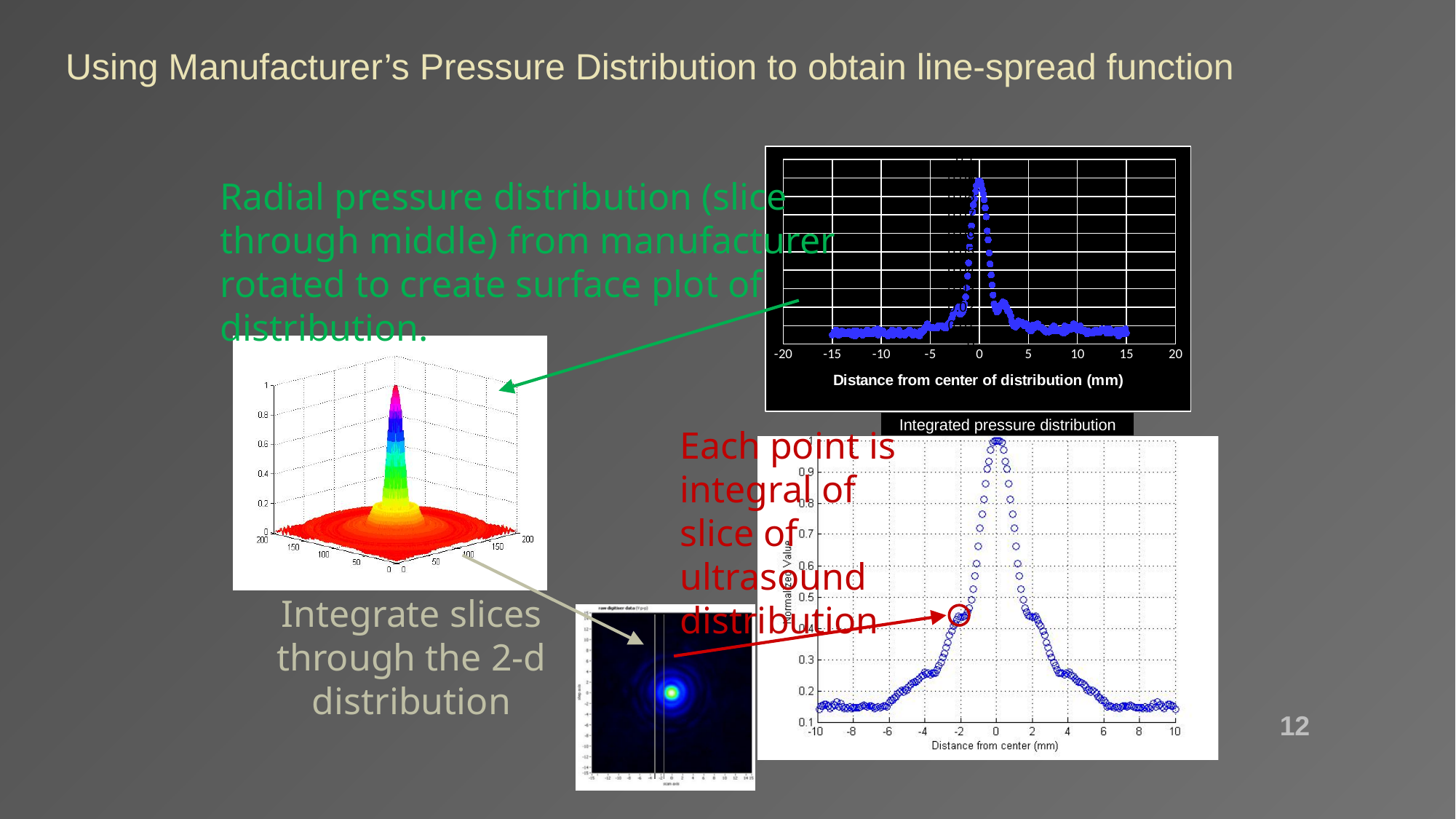
In the 'Integrated pressure distribution' chart, is the value at -2 mm greater or less than 0.3? greater What is the x-axis label of the 'Integrated pressure distribution' chart? Distance from center (mm) What is the title of the bottom-right chart? Integrated pressure distribution In the 'Integrated pressure distribution' chart, which is larger: the value at 2 mm or the value at 6 mm? 2 mm In the 'Integrated pressure distribution' chart, at what distance from center is the value highest? 0 mm In the 'Integrated pressure distribution' chart, is the value at 0 mm greater or less than 0.9? greater In the 'Integrated pressure distribution' chart, do the values rise or fall as the distance goes from -10 mm to 0 mm? rise In the 'Integrated pressure distribution' chart, is the value at -8 mm greater or less than 0.2? less In the 'Integrated pressure distribution' chart, do the values rise or fall as the distance goes from 0 mm to 10 mm? fall In the top-right chart, which is larger: the value at -15 mm or the value at 0 mm? 0 mm What kind of chart is the 'Integrated pressure distribution' chart? scatter plot In the top-right chart, at what distance from center of distribution is the value highest? 0 mm